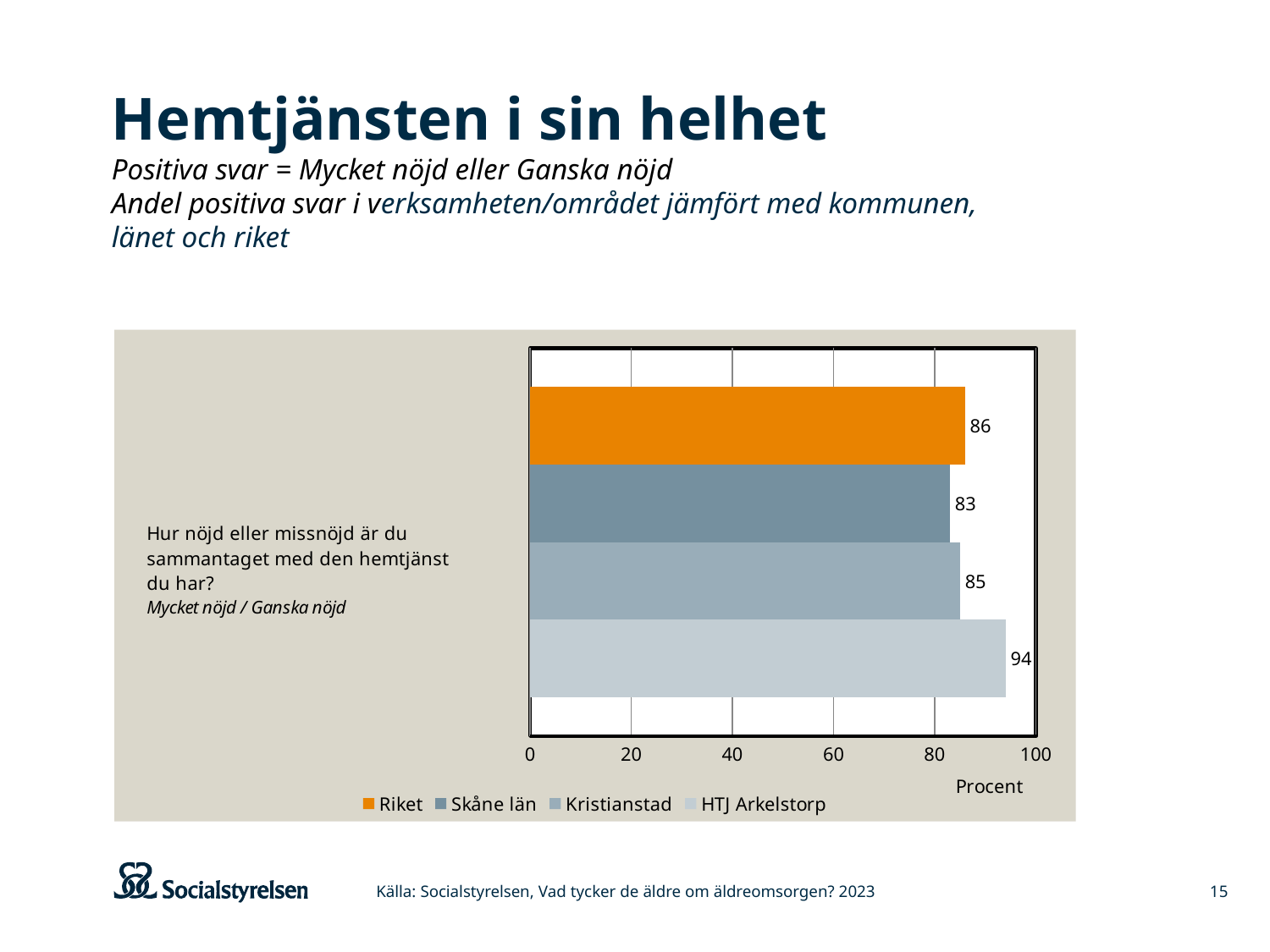
How many series does the legend list? 4 What kind of chart is shown on the slide? Bar chart Which series has the lowest value? Skåne län Which is larger, the value for Riket or the value for Kristianstad? Riket What is the difference between the values for Kristianstad and Skåne län? 2 What is the value for HTJ Arkelstorp? 94 Which series has the highest value? HTJ Arkelstorp What is the difference between the values for HTJ Arkelstorp and Riket? 8 What is the value for Riket? 86 What is the label on the horizontal axis of the chart? Procent What is the value for Skåne län? 83 What is the value for Kristianstad? 85